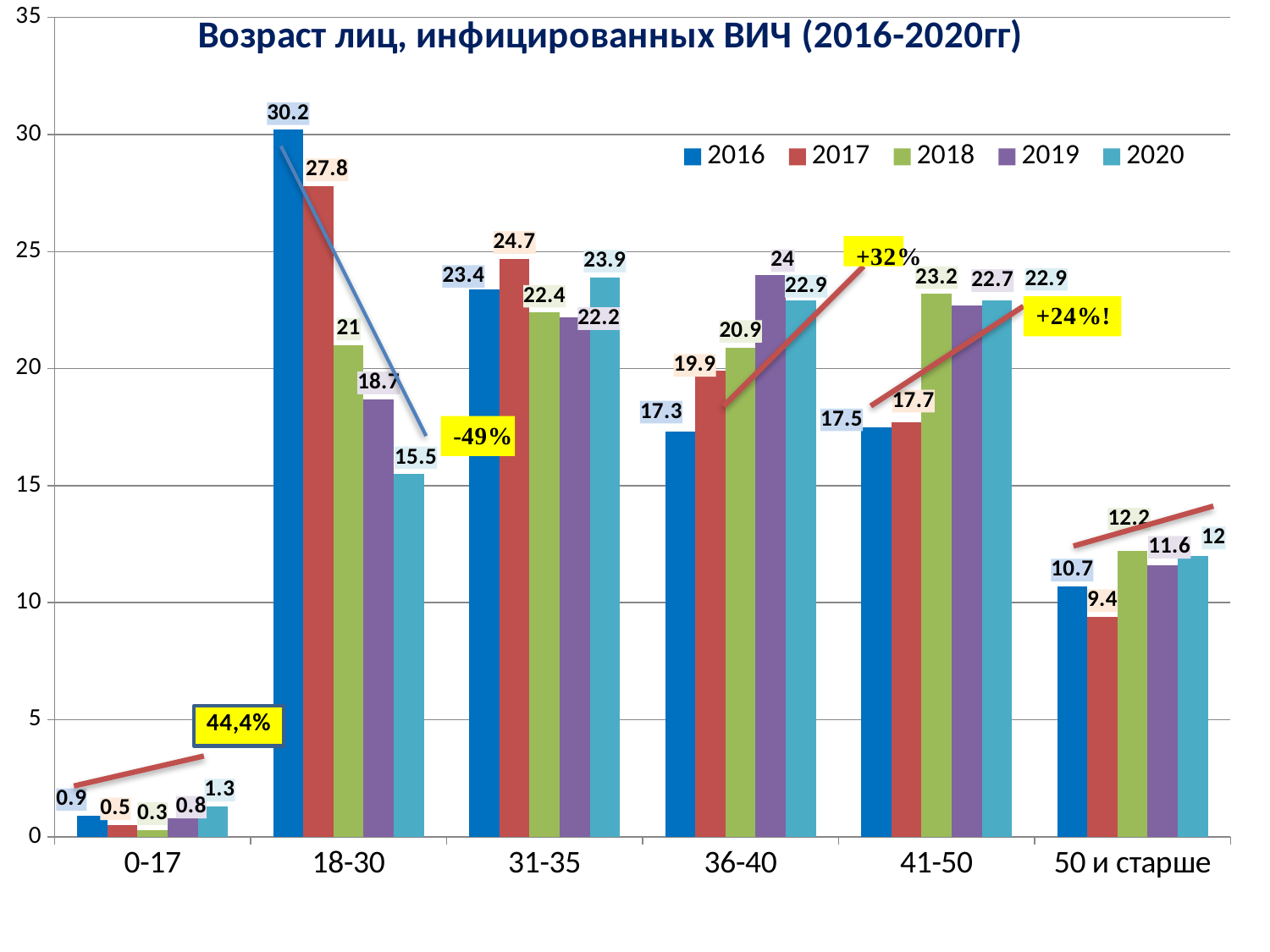
Which is larger in the 41-50 age group: the 2016 value or the 2018 value? 2018 Which age group has the highest value for 2016? 18-30 What is the value for 2019 in the 36-40 age group? 24 Do the values for the 18-30 age group rise or fall from 2016 to 2020? fall What kind of chart is shown on the slide? bar chart What is the value for 2017 in the '50 и старше' age group? 9.4 What is the value for 2016 in the 18-30 age group? 30.2 How many series does the legend list? 5 What is the difference between the 2016 and 2020 values in the 18-30 age group? 14.7 How many age groups are shown on the x axis? 6 Which age group has the lowest value for 2018? 0-17 What is the value for 2020 in the 0-17 age group? 1.3